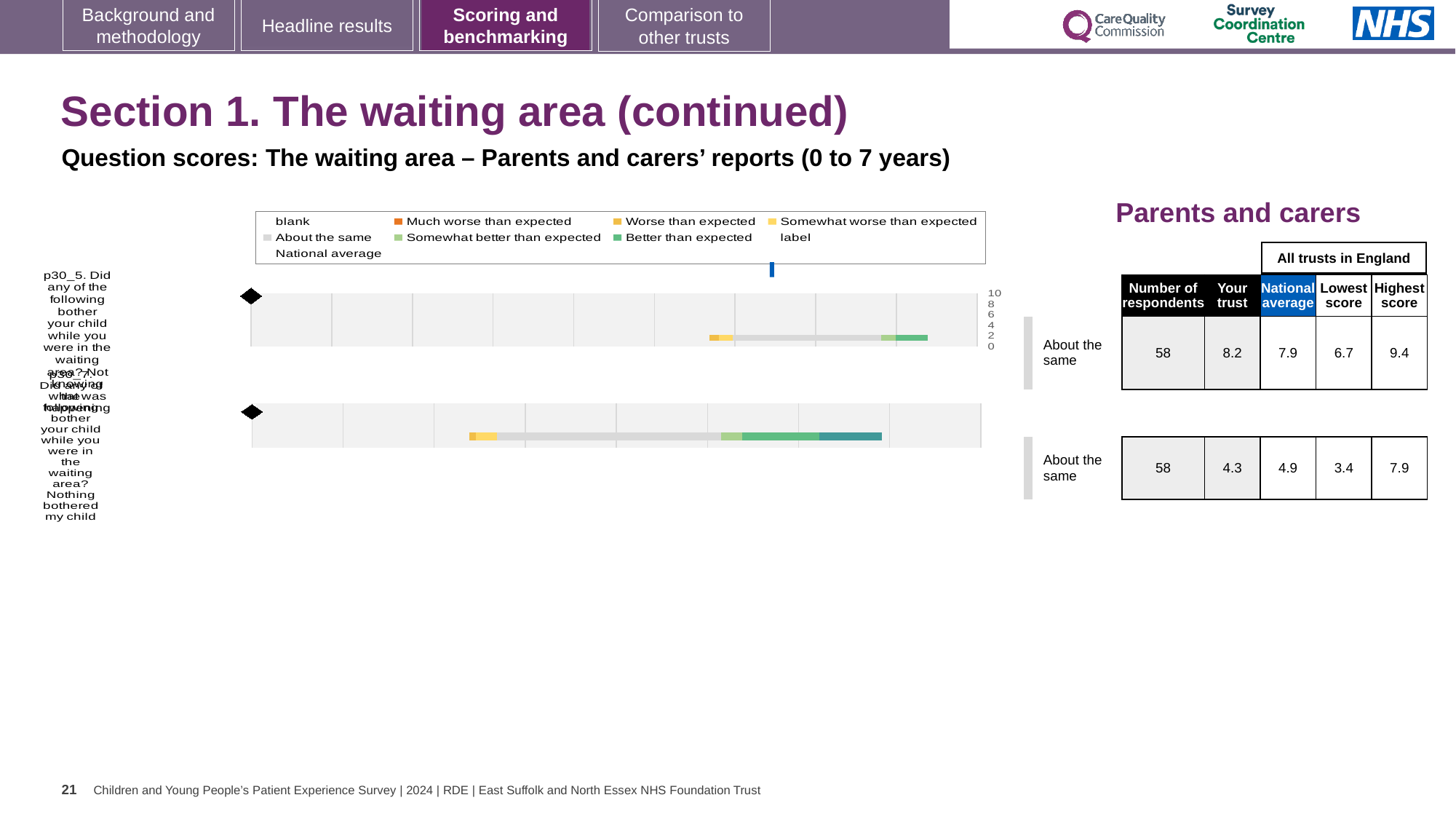
How many entries does the chart legend list? 9 What is the national average score for question p30_5? 7.9 What benchmark category is shown next to both question rows in the chart? About the same How many question rows (bars) are plotted in the chart? 2 What is the highest score among all trusts in England for question p30_7? 7.9 What is the 'Your trust' score for question p30_5 (did any of the following bother your child while in the waiting area? Not knowing what was happening)? 8.2 What is the difference between the highest score and the lowest score for question p30_5? 2.7 What kind of chart is shown on the slide? bar chart What is the difference between the national average and the 'Your trust' score for question p30_7? 0.6 For question p30_5, which is larger: the 'Your trust' score or the national average? Your trust How many respondents answered question p30_5? 58 What is the lowest score among all trusts in England for question p30_7 (Nothing bothered my child)? 3.4